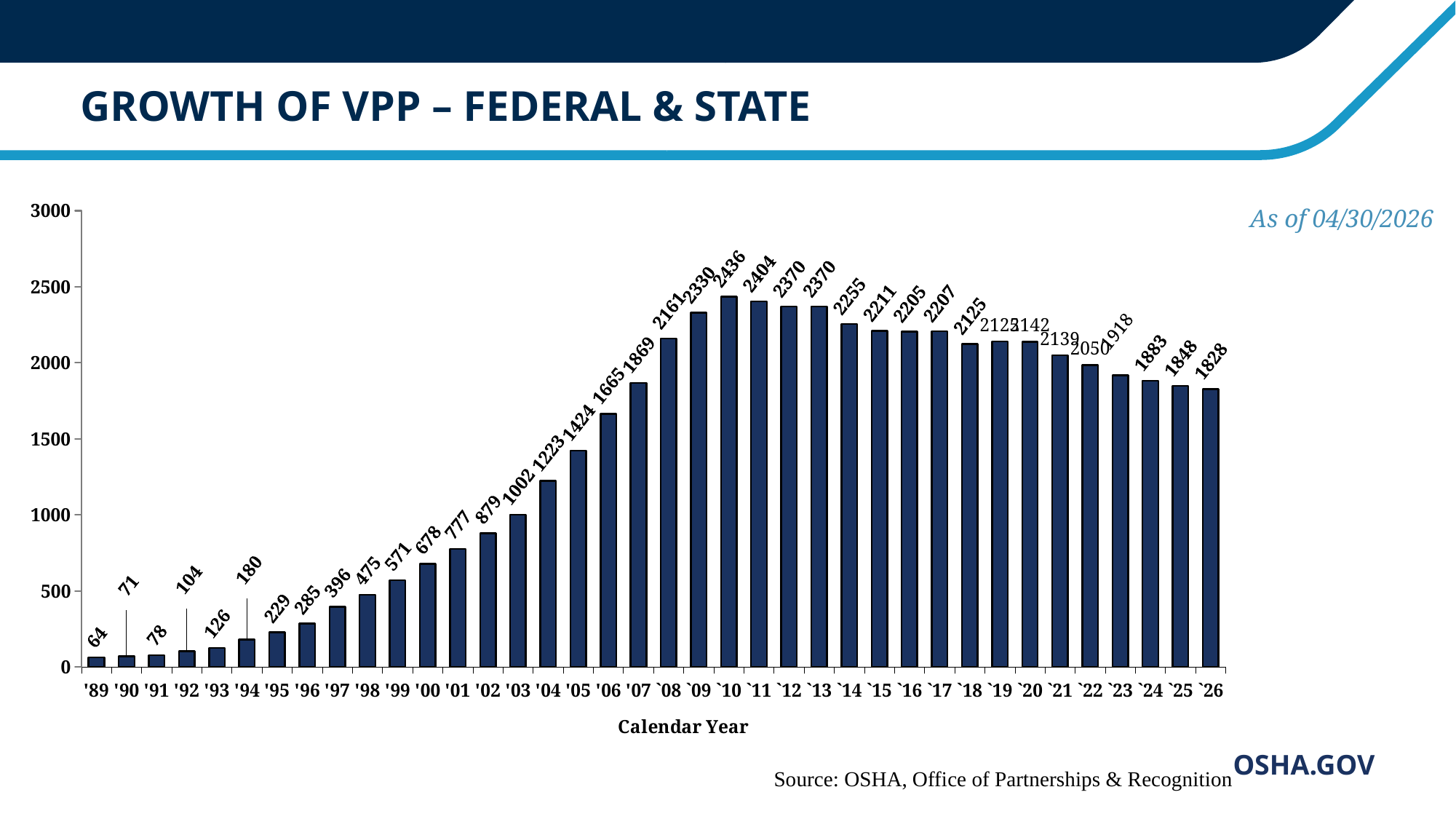
What is the value for '89? 64 What is the value for '26? 1828 What is the difference between the values for '10 and '26? 608 What is the label of the x axis? Calendar Year What type of chart is shown on the slide? bar chart What is the value for '10? 2436 What is the value for '03? 1002 Which year has the lowest value? '89 How many years are plotted on the chart? 38 Which is larger, the value for '07 or the value for '24? '24 Which year has the highest value? '10